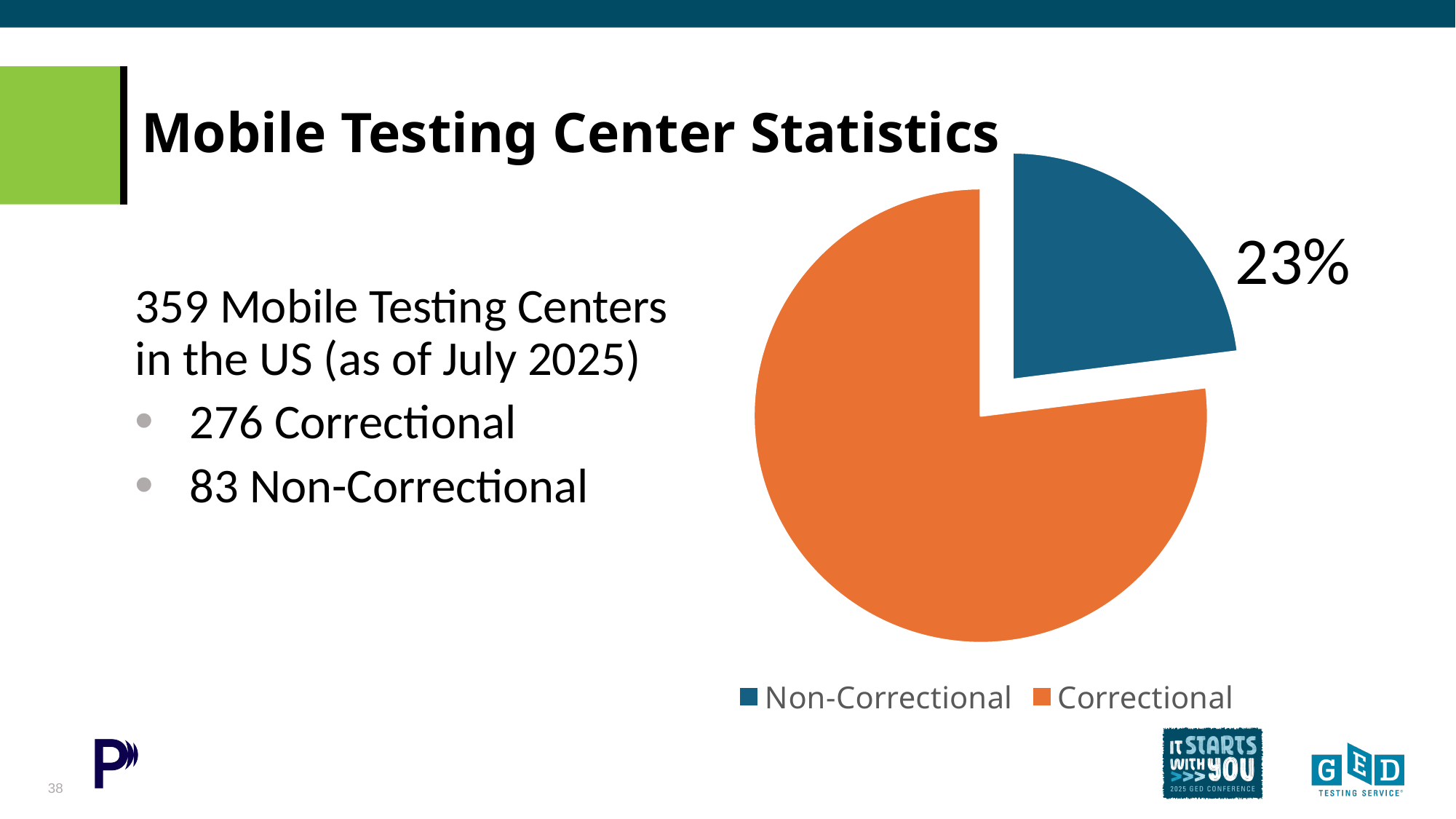
What kind of chart is shown on the slide? Pie chart Is the Correctional slice greater or less than half of the pie? greater Which category has the largest slice in the pie chart? Correctional How many slices does the pie chart have? 2 What share of the pie does the Non-Correctional slice represent? 23% Which slice is pulled out (exploded) from the pie chart? Non-Correctional What colour is the Non-Correctional slice in the pie chart? Blue How many entries does the legend of the pie chart list? 2 Which slice is larger, Correctional or Non-Correctional? Correctional Which category has the smallest slice in the pie chart? Non-Correctional